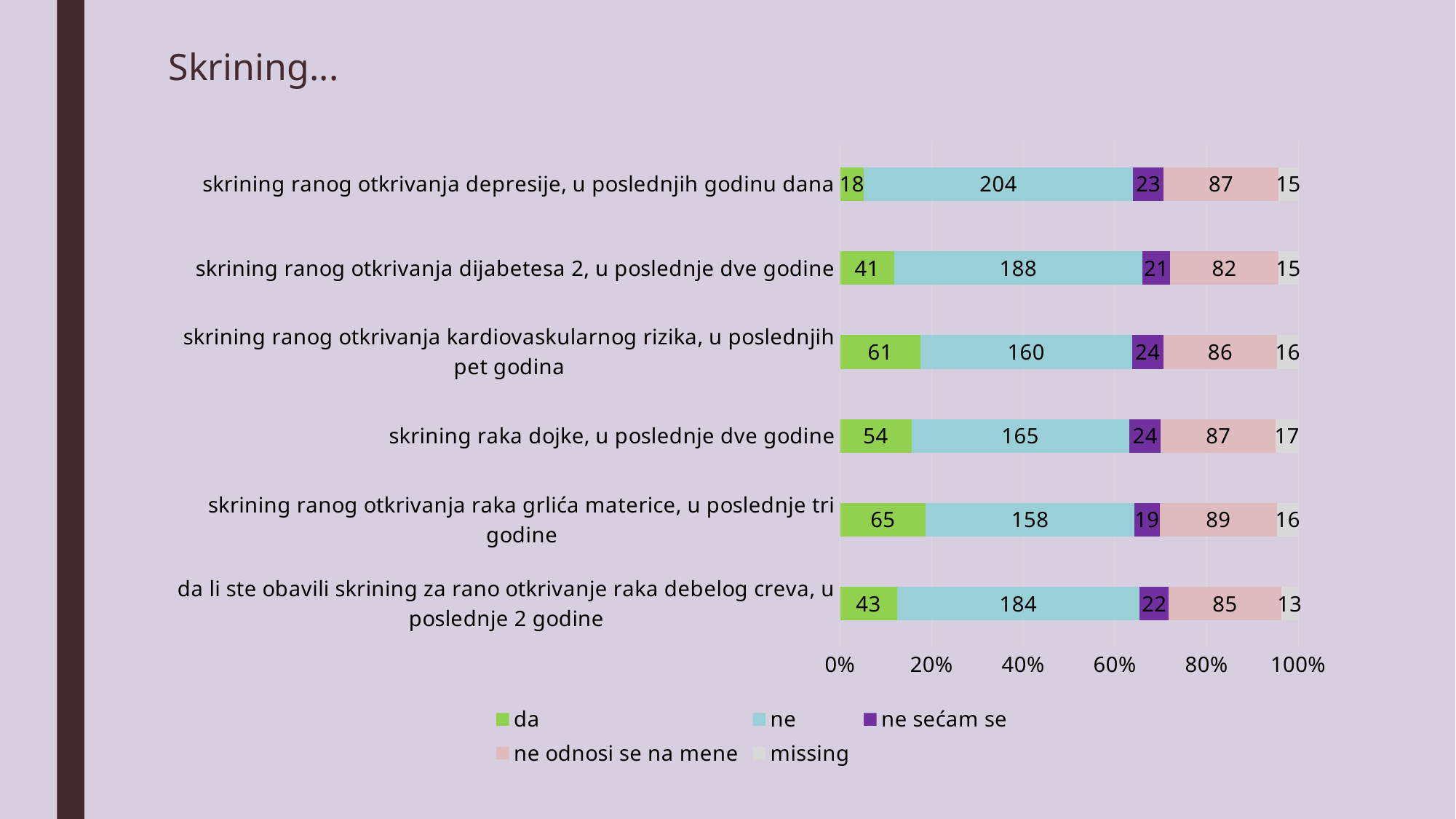
What is the value of "da" for "skrining ranog otkrivanja depresije, u poslednjih godinu dana"? 18 What is the value of "ne" for "skrining ranog otkrivanja dijabetesa 2, u poslednje dve godine"? 188 How many categories are shown on the chart? 6 What is the "missing" value for "da li ste obavili skrining za rano otkrivanje raka debelog creva, u poslednje 2 godine"? 13 What kind of chart is shown on the slide? stacked bar chart Which category has the highest "da" value? skrining ranog otkrivanja raka grlića materice, u poslednje tri godine What is the total of all segments for "skrining ranog otkrivanja depresije, u poslednjih godinu dana"? 347 Which has a larger "ne odnosi se na mene" value: raka grlića materice or dijabetesa 2? skrining ranog otkrivanja raka grlića materice, u poslednje tri godine How many series does the legend list? 5 What is the difference between the "ne" value for depresije and the "ne" value for raka grlića materice? 46 What colour represents the "da" series in the legend? green Which category has the lowest "da" value? skrining ranog otkrivanja depresije, u poslednjih godinu dana